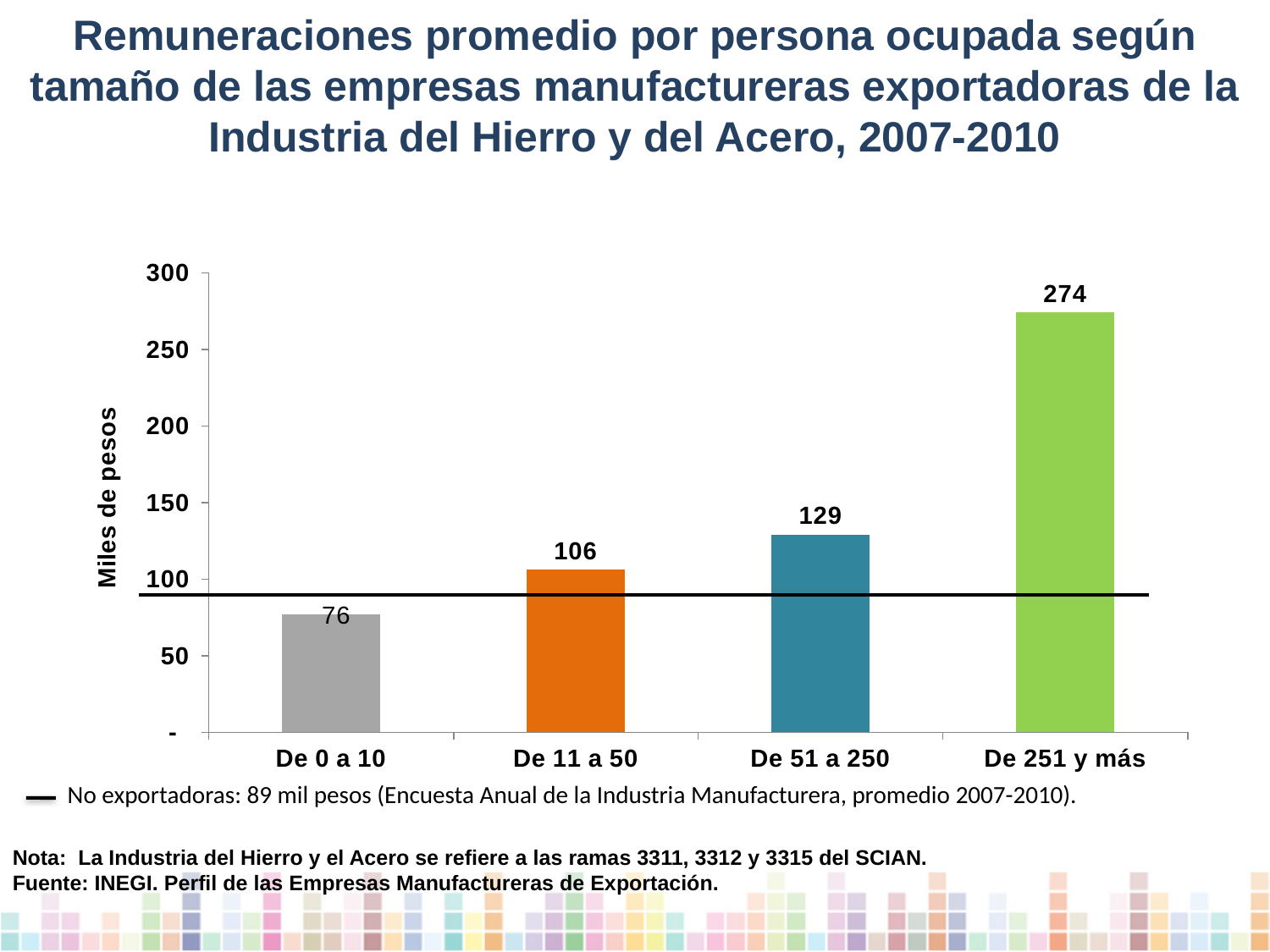
What kind of chart is this? Bar chart Which category has the lowest value? De 0 a 10 What is the value for the 'De 11 a 50' category? 106 Which category has the highest value? De 251 y más How many categories are shown on the x axis? 4 What is the value for the 'De 251 y más' category? 274 What is the difference between the values for 'De 251 y más' and 'De 51 a 250'? 145 Do the values rise or fall from left to right along the x axis? Rise What is the value for the 'De 0 a 10' category? 76 What is the label of the y axis? Miles de pesos Which is larger, the value for 'De 11 a 50' or 'De 51 a 250'? De 51 a 250 What is the value for the 'De 51 a 250' category? 129